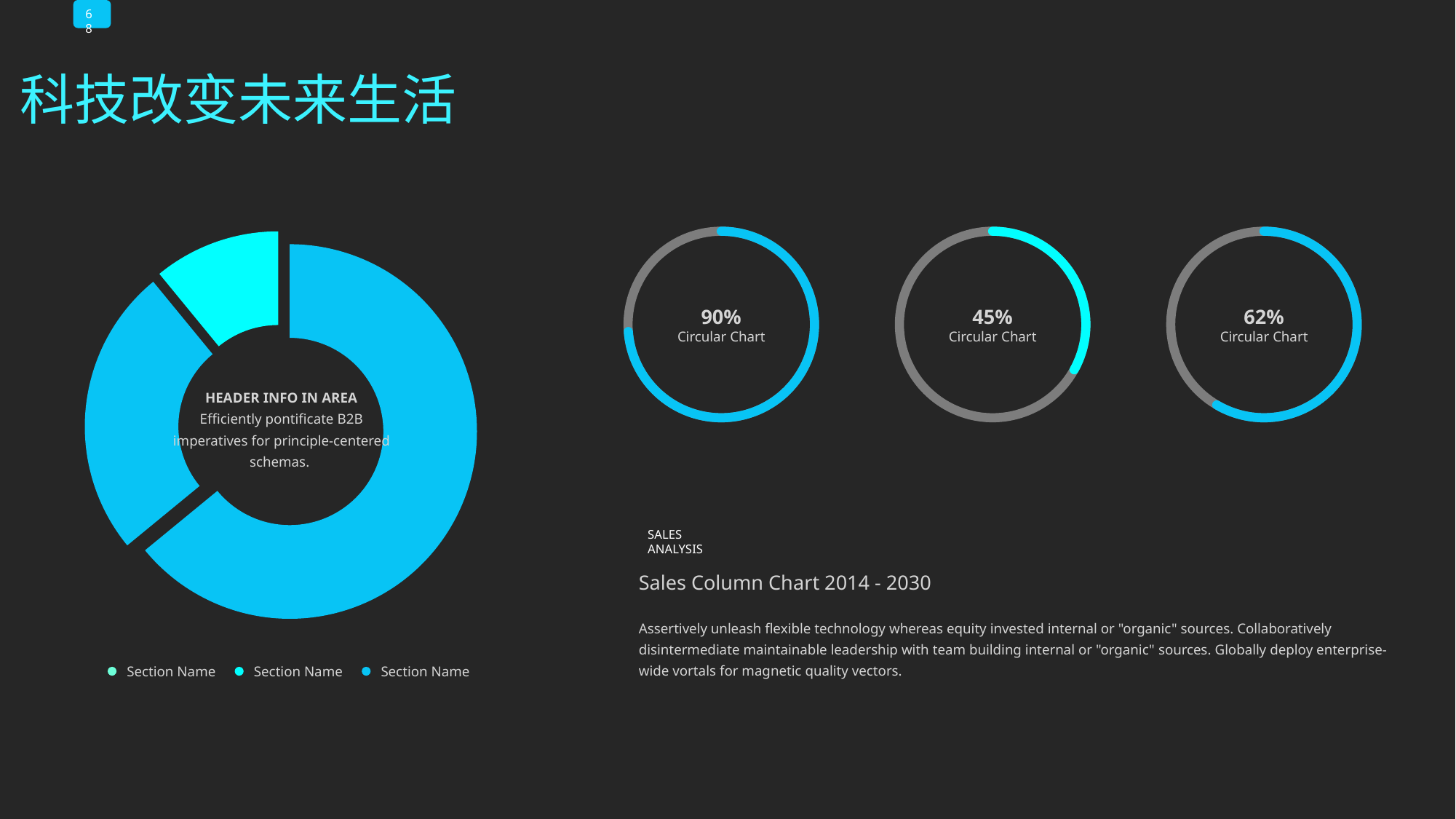
How many circular charts are shown on the right side of the slide? 3 What value is shown in the leftmost circular chart? 90% What value is shown in the middle circular chart? 45% Which of the three circular charts shows the highest value? The leftmost one (90%) What text is shown in the centre of the donut chart as its header? HEADER INFO IN AREA What label is used for each entry in the legend below the donut chart? Section Name How many entries does the legend below the donut chart list? 3 What value is shown in the rightmost circular chart? 62% What is the difference between the values of the leftmost and middle circular charts? 45 percentage points Which of the three circular charts shows the lowest value? The middle one (45%) What kind of chart is shown on the left side of the slide? Donut (pie) chart How many slices does the donut chart on the left have? 3